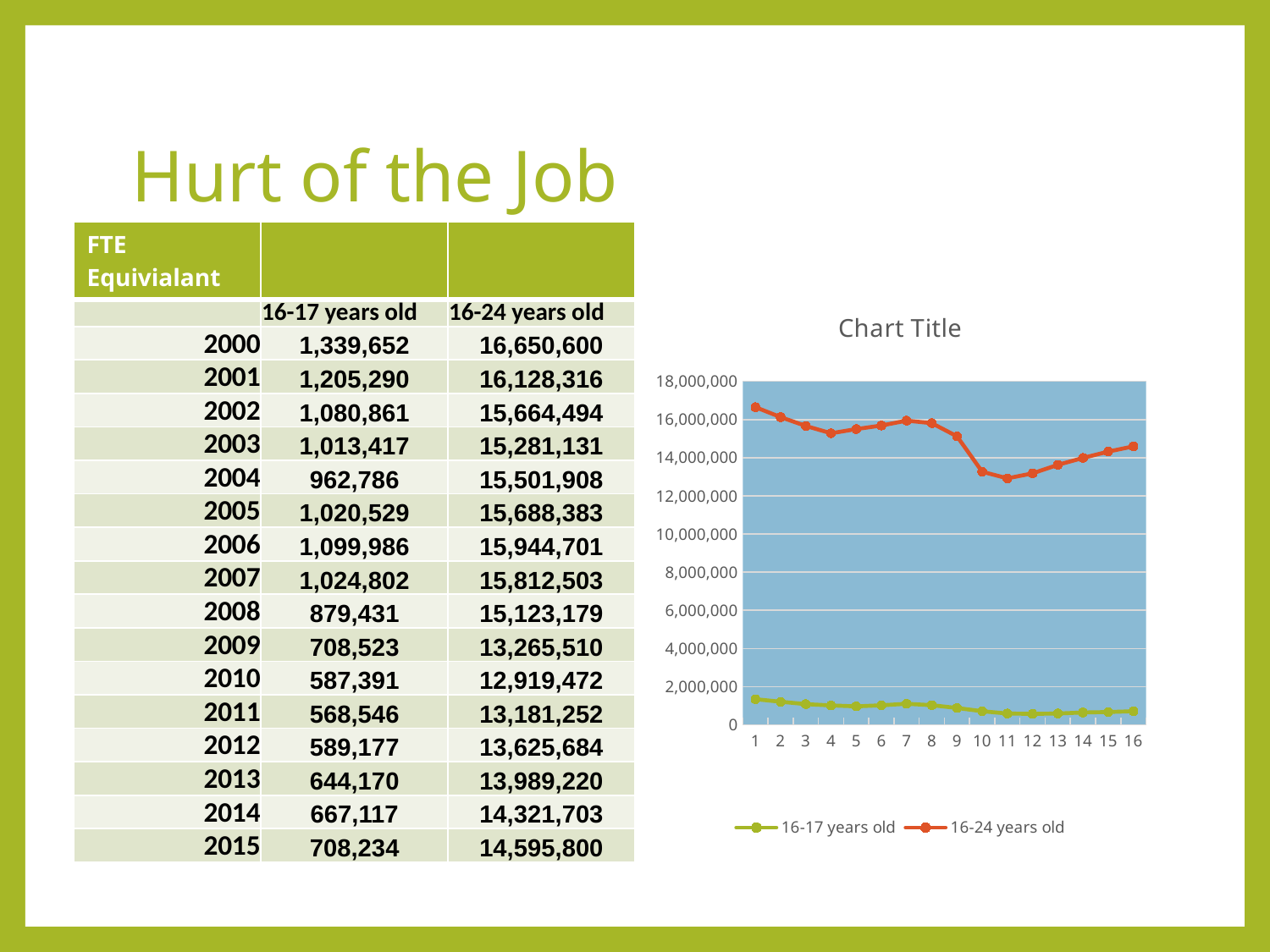
How many points are plotted along the x axis of the chart? 16 How many series does the chart's legend list? 2 Is the value for 16-17 years old at point 16 greater or less than 2,000,000? less Is the value for 16-24 years old at point 1 greater or less than 16,000,000? greater At point 1 on the chart, which series has the higher value, 16-17 years old or 16-24 years old? 16-24 years old What are the two series named in the chart's legend? 16-17 years old and 16-24 years old What is the title shown above the chart? Chart Title Does the 16-24 years old line rise or fall from point 11 to point 16? rise Does the 16-24 years old line rise or fall from point 1 to point 11? fall Is the value for 16-24 years old at point 11 greater or less than 14,000,000? less What kind of chart is shown on the slide? line chart At which x-axis point does the 16-24 years old series reach its highest value? 1